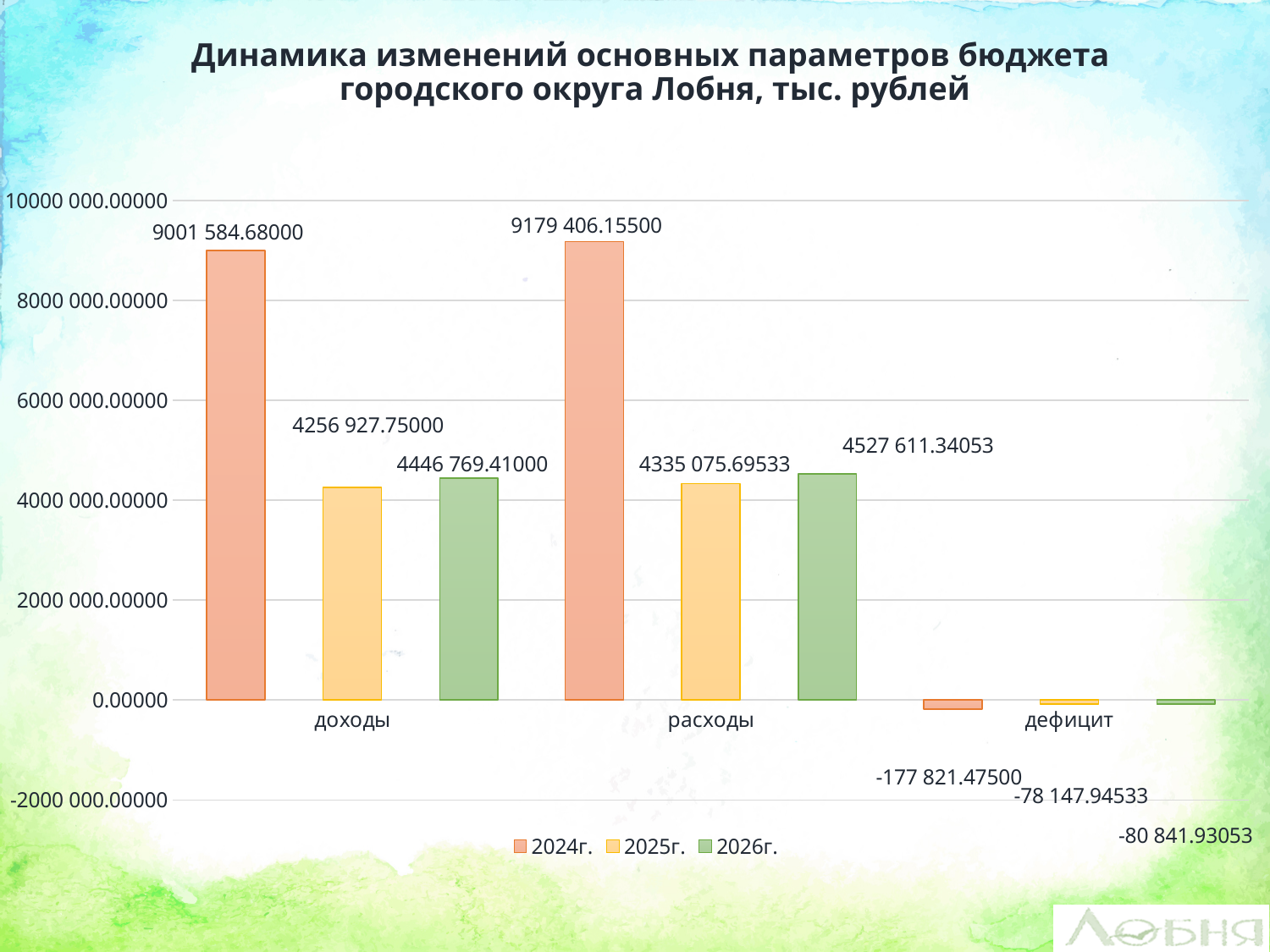
What is the value for расходы in 2026г.? 4527 611.34053 Is the value for расходы in 2025г. greater or less than 6000 000.00000? less Which category has the highest value for 2024г.? расходы Which category has the lowest value for 2026г.? дефицит What is the value for дефицит in 2025г.? -78 147.94533 What type of chart is shown on the slide? bar chart Which series is shown in green in the legend? 2026г. How many series does the legend list? 3 What is the value for доходы in 2024г.? 9001 584.68000 What is the difference between расходы and доходы in 2024г.? 177 821.47500 How many categories are shown on the x axis? 3 Which is larger: доходы in 2025г. or доходы in 2026г.? доходы in 2026г.